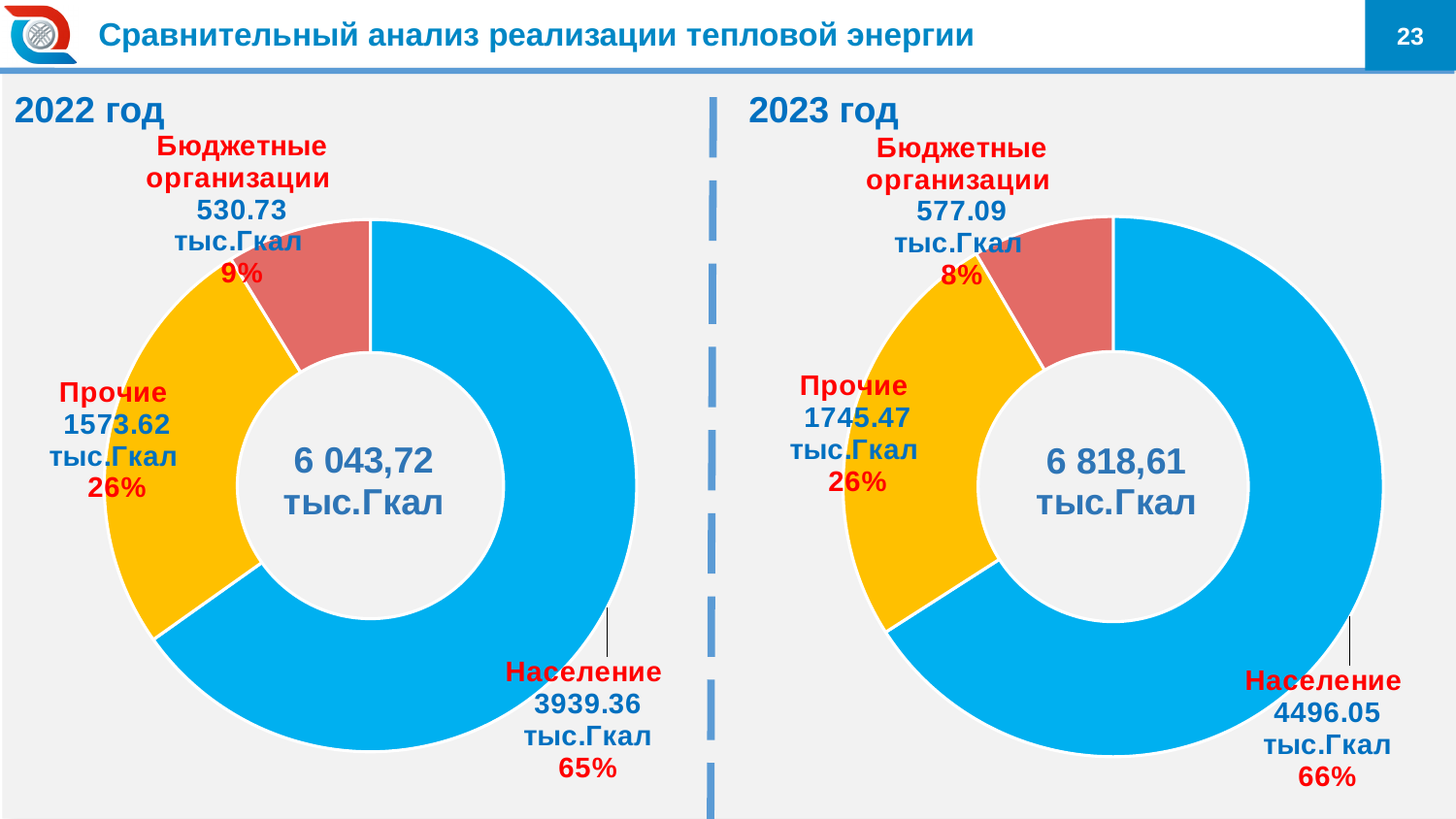
In the 2023 год chart, what is the value for Прочие? 1745.47 тыс.Гкал How many categories are shown in the 2022 год chart? 3 What type of chart is used for the 2023 год data? Pie (donut) chart In the 2022 год chart, which category has the smallest value? Бюджетные организации What is the total shown in the centre of the 2023 год chart? 6 818,61 тыс.Гкал In the 2022 год chart, what share of the total does Прочие account for? 26% In the 2023 год chart, what share of the total does Население account for? 66% In the 2023 год chart, which category has the largest value? Население In the 2023 год chart, what is the value for Бюджетные организации? 577.09 тыс.Гкал What is the total shown in the centre of the 2022 год chart? 6 043,72 тыс.Гкал In the 2022 год chart, what is the value for Население? 3939.36 тыс.Гкал By how much did the value for Население increase from the 2022 год chart to the 2023 год chart? 556.69 тыс.Гкал